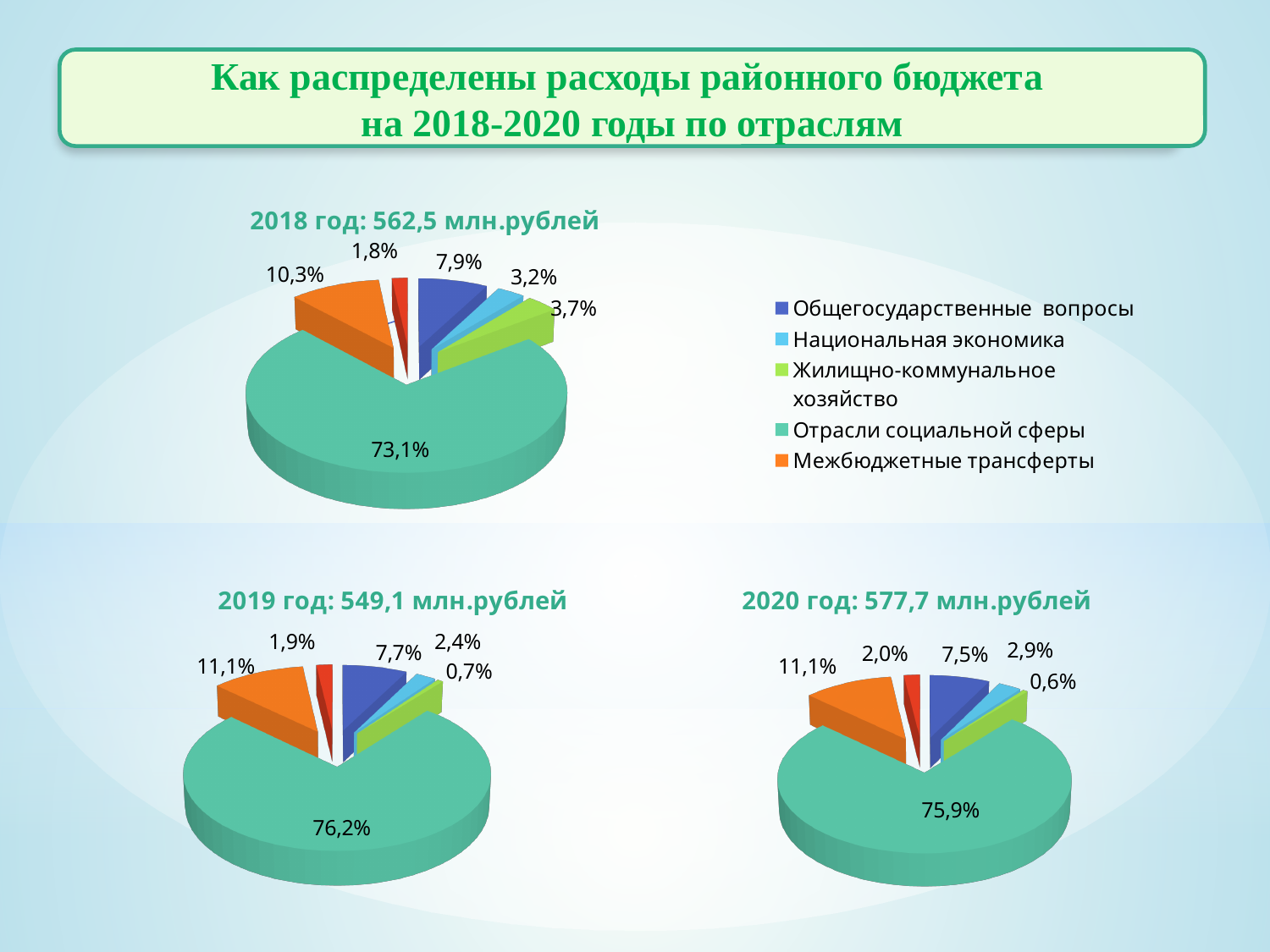
In the 2018 pie chart, what is the difference between the shares of Межбюджетные трансферты and Общегосударственные вопросы? 2,4% How many categories does the legend list? 5 In the 2019 pie chart, what share is shown for Межбюджетные трансферты? 11,1% In the 2019 pie chart, which category has the largest share? Отрасли социальной сферы What kind of chart is used on this slide? Pie chart In the 2020 pie chart, what share is shown for Жилищно-коммунальное хозяйство? 0,6% In the 2018 pie chart, what share is shown for Отрасли социальной сферы? 73,1% In the 2019 pie chart, which legend category has the smallest share? Жилищно-коммунальное хозяйство What total amount is given in the title of the 2019 pie chart? 549,1 млн.рублей In the 2020 pie chart, what share is shown for Общегосударственные вопросы? 7,5% What total amount is given in the title of the 2020 pie chart? 577,7 млн.рублей In the 2018 pie chart, which is larger: the share of Национальная экономика or the share of Жилищно-коммунальное хозяйство? Жилищно-коммунальное хозяйство